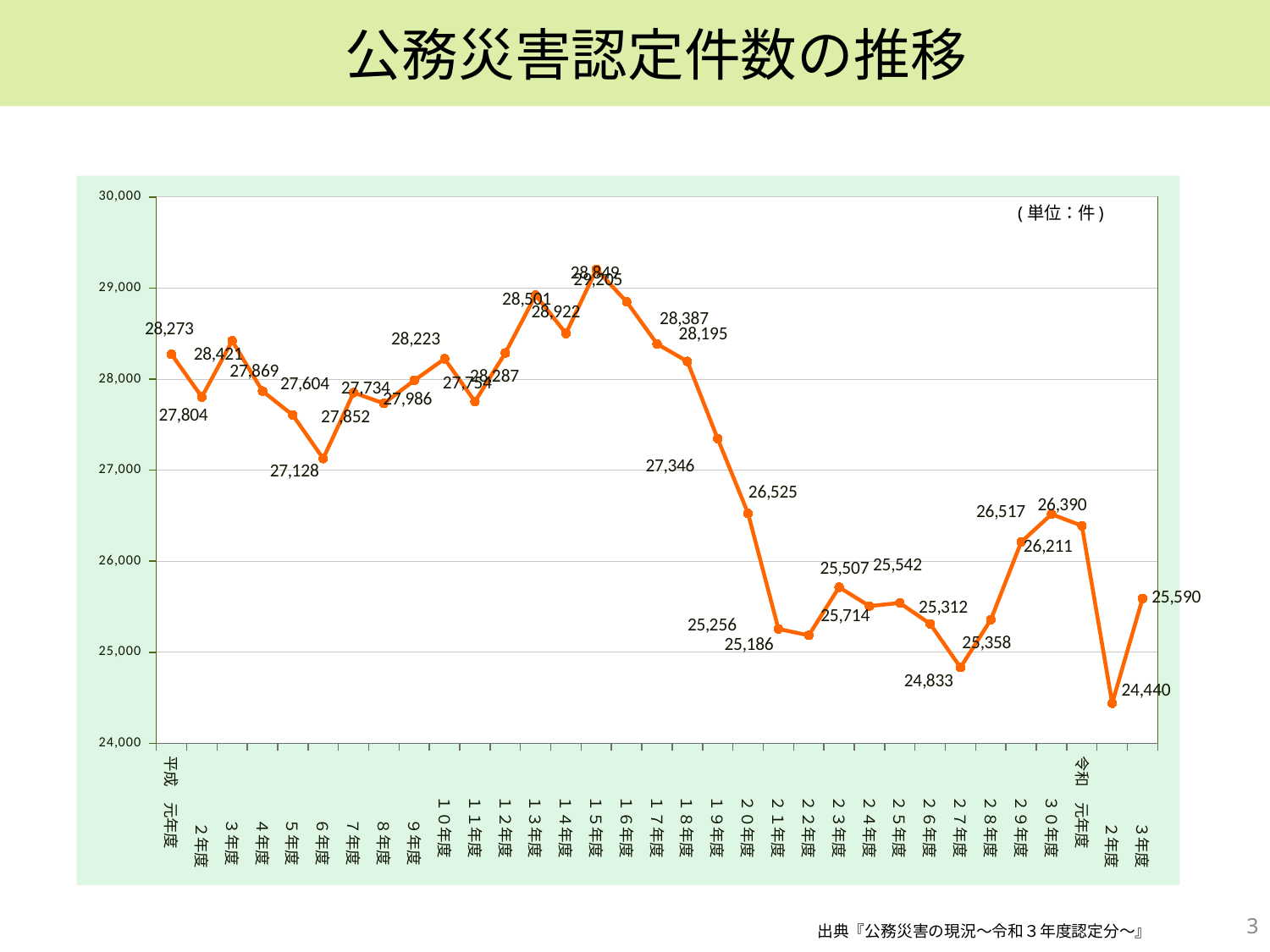
What kind of chart is shown on the slide? line chart Is the value for 平成20年度 greater or less than 27,000? less Which fiscal year has the lowest number of recognized public service accidents? 令和2年度 What unit is indicated in the top-right corner of the chart? 件 Which fiscal year has the highest number of recognized public service accidents? 平成15年度 What is the value at the peak in 平成15年度? 29,205 Which is larger, the value for 平成元年度 or the value for 令和3年度? 平成元年度 How many fiscal years are plotted on the chart? 33 What is the value for 平成元年度? 28,273 What is the difference between the values for 令和3年度 and 令和2年度? 1,150 What is the value for 令和2年度? 24,440 What is the value for 令和3年度? 25,590